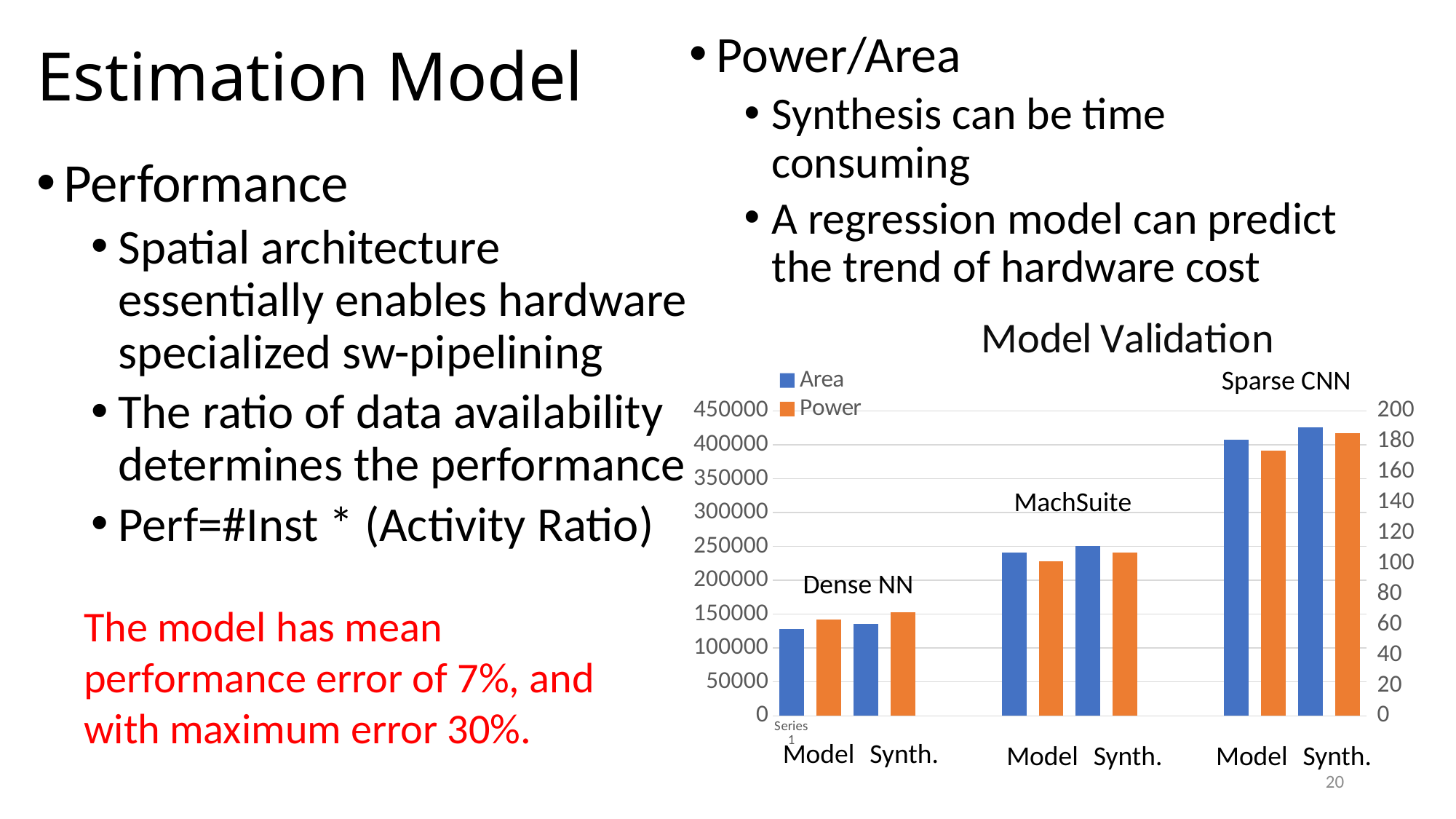
In the Model Validation chart, do the Area values rise or fall going from Dense NN to MachSuite to Sparse CNN? rise In the Model Validation chart, which is larger: the Area value for Sparse CNN Model or the Area value for MachSuite Synth.? Sparse CNN Model In the Model Validation chart, is the Area value for the Sparse CNN Synth. bar greater or less than 400000? greater What are the two series named in the legend of the Model Validation chart? Area and Power What kind of chart is the Model Validation chart? bar chart In the Model Validation chart, is the Area value for the MachSuite Model bar greater or less than 200000? greater In the Model Validation chart, which benchmark has the lowest Area bars? Dense NN In the Model Validation chart, is the Area value for the Dense NN Model bar greater or less than 150000? less In the Model Validation chart, which benchmark has the highest Area bars? Sparse CNN How many benchmark groups (Dense NN, MachSuite, Sparse CNN) are shown in the Model Validation chart? 3 How many series does the legend of the Model Validation chart list? 2